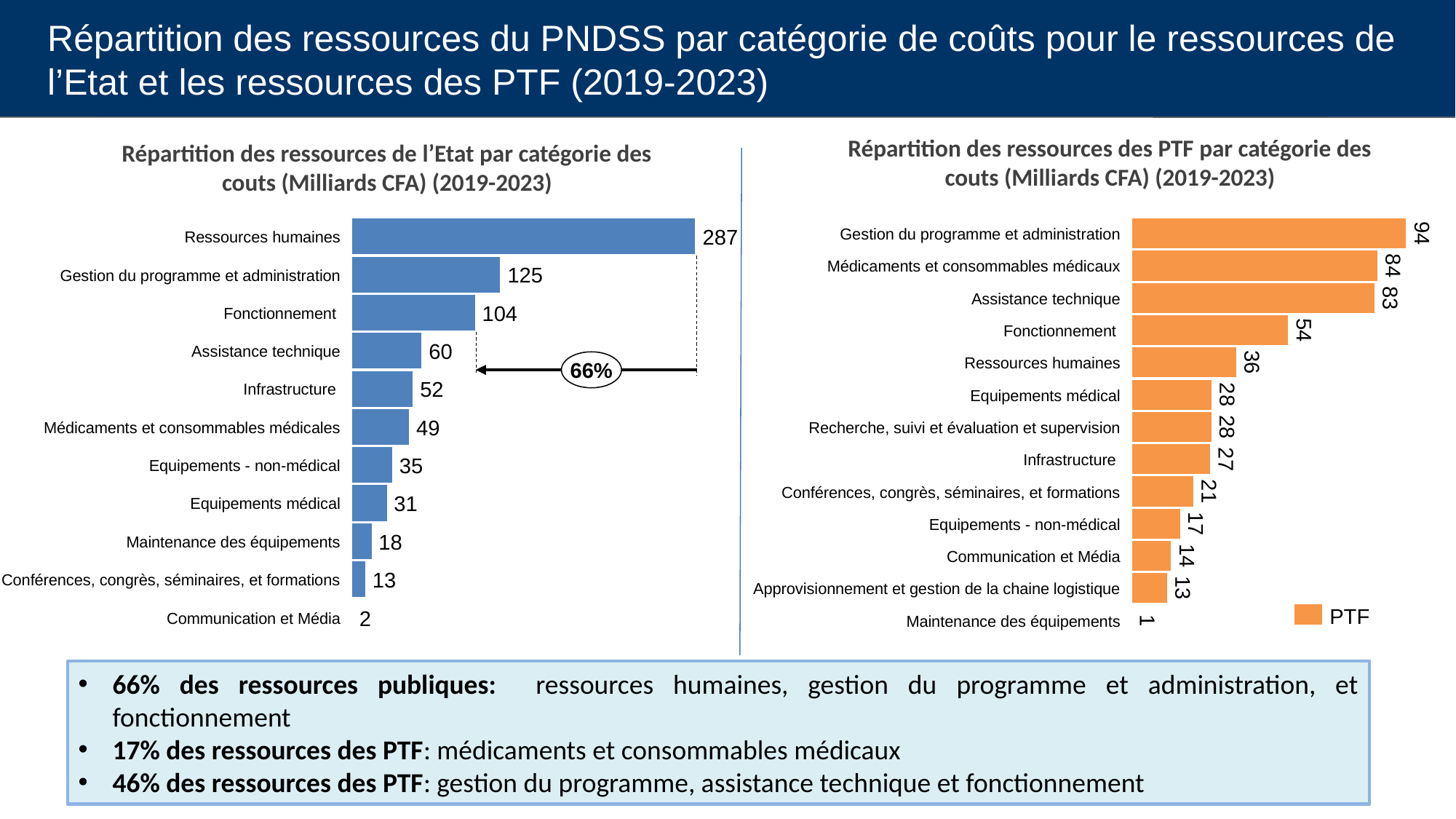
In the right chart (Répartition des ressources des PTF), which is larger: Fonctionnement or Ressources humaines? Fonctionnement In the right chart (Répartition des ressources des PTF), what is the difference between Gestion du programme et administration and Assistance technique? 11 In the left chart (Répartition des ressources de l'Etat), what is the value for Fonctionnement? 104 In the left chart (Répartition des ressources de l'Etat), how many categories are shown? 11 What kind of chart is the right chart (Répartition des ressources des PTF)? Bar chart In the left chart (Répartition des ressources de l'Etat), what is the difference between Gestion du programme et administration and Assistance technique? 65 In the right chart (Répartition des ressources des PTF), what series name does the legend show? PTF In the right chart (Répartition des ressources des PTF), which category has the highest value? Gestion du programme et administration In the right chart (Répartition des ressources des PTF), how many categories are shown? 13 In the left chart (Répartition des ressources de l'Etat), what is the value for Ressources humaines? 287 In the left chart (Répartition des ressources de l'Etat), which category has the lowest value? Communication et Média In the right chart (Répartition des ressources des PTF), what is the value for Médicaments et consommables médicaux? 84